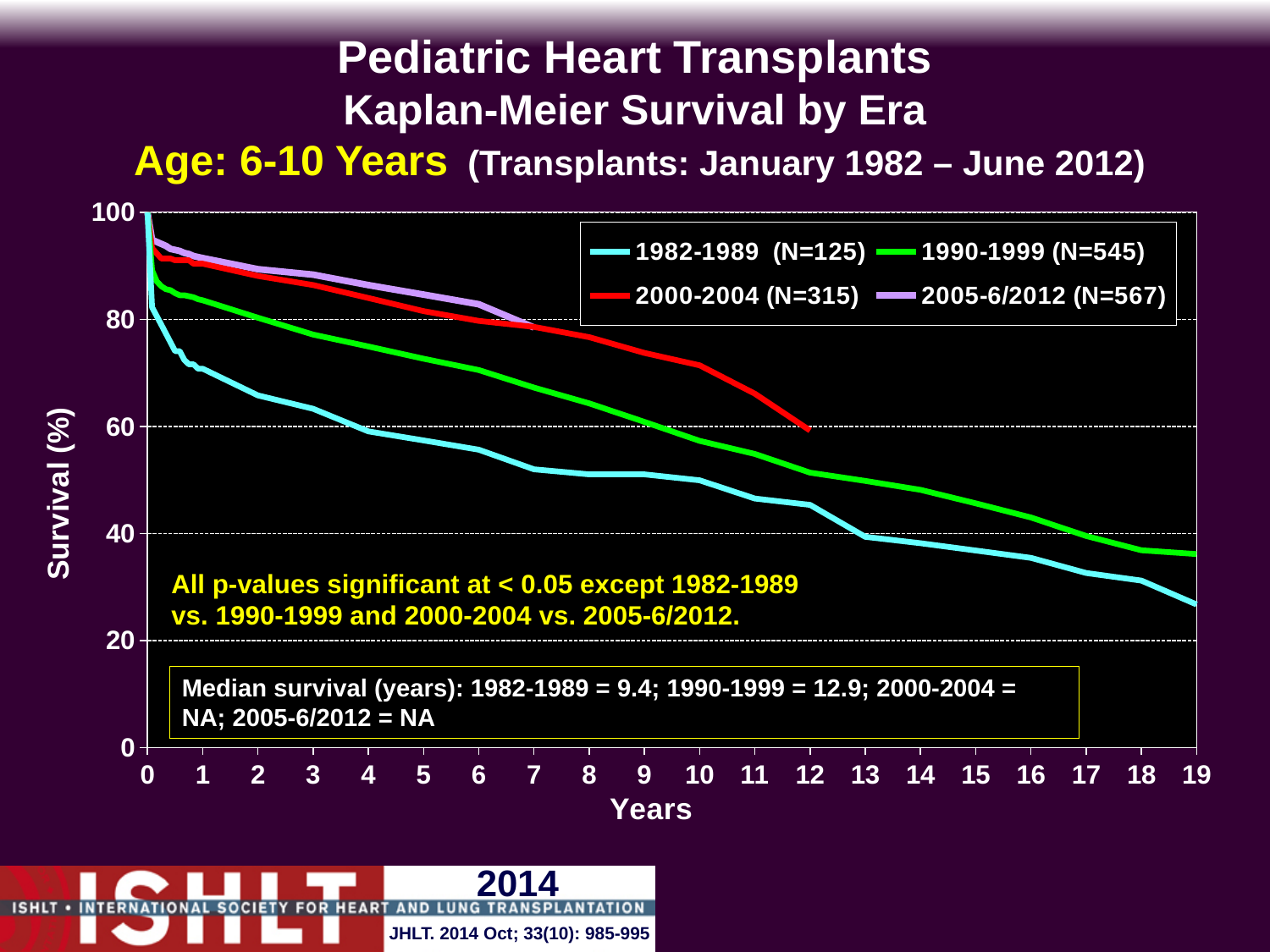
Is the survival value for the 2005-6/2012 era at year 6 greater or less than 80? greater How many series does the legend list? 4 Is the survival value for the 1990-1999 era at year 19 greater or less than 40? less What kind of chart is shown on the slide? Line chart Which era has the lowest survival at year 10? 1982-1989 Is the survival value for the 2000-2004 era at year 10 greater or less than 60? greater At year 5, which era has higher survival: 1982-1989 or 1990-1999? 1990-1999 According to the text box on the chart, what is the median survival in years for the 1990-1999 era? 12.9 At year 8, which era has higher survival: 2000-2004 or 1990-1999? 2000-2004 Do the survival curves rise or fall as years since transplant increase? Fall